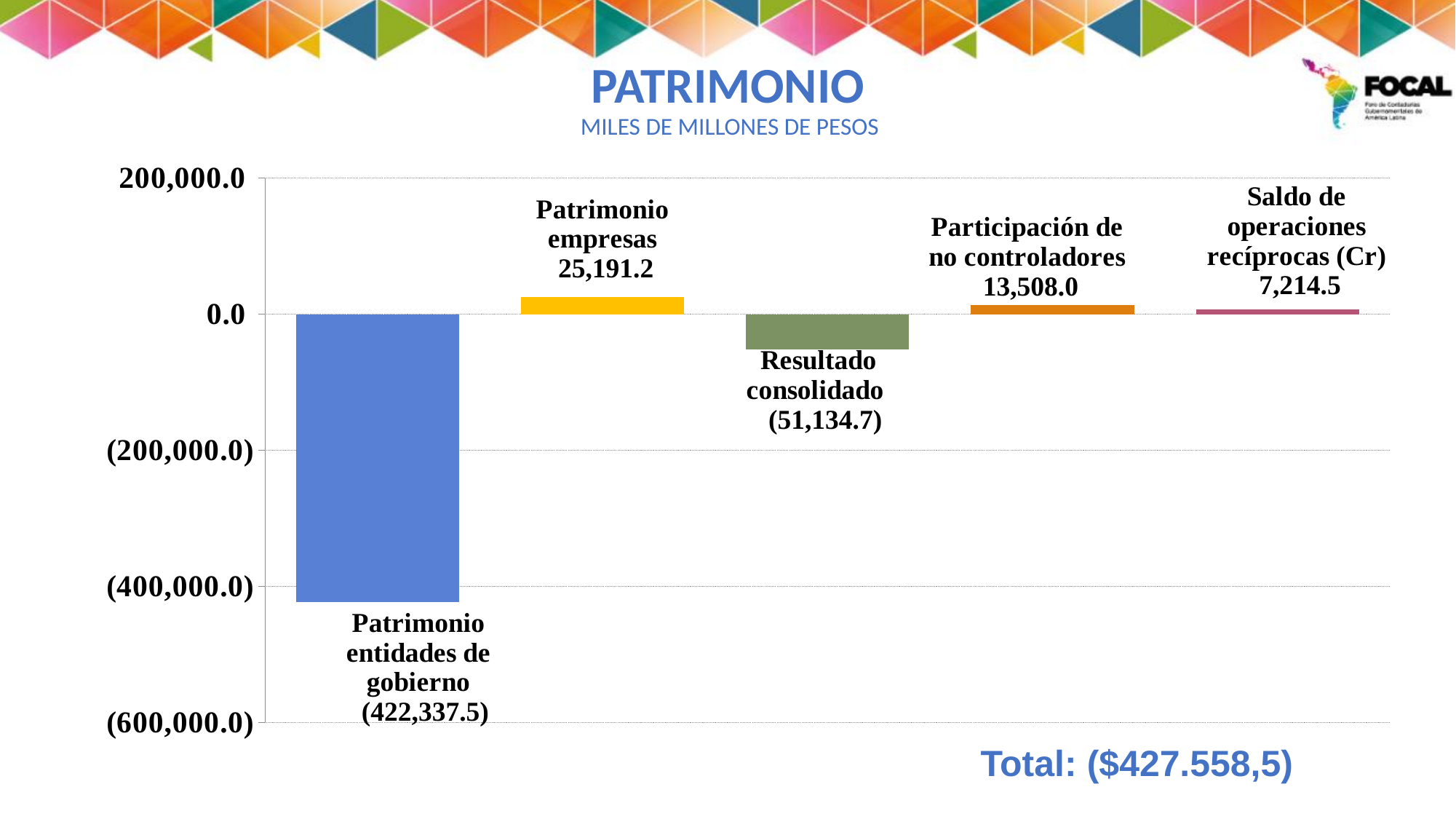
What total is printed below the chart? ($427.558,5) Which category has the lowest value? Patrimonio entidades de gobierno Which is larger, the value for Participación de no controladores or the value for Saldo de operaciones recíprocas (Cr)? Participación de no controladores What is the value for Saldo de operaciones recíprocas (Cr)? 7,214.5 What is the value for Patrimonio entidades de gobierno? (422,337.5) What is the value for Participación de no controladores? 13,508.0 What is the value for Patrimonio empresas? 25,191.2 What kind of chart is shown on the slide? Bar chart What is the difference between the values for Patrimonio empresas and Participación de no controladores? 11,683.2 What is the value for Resultado consolidado? (51,134.7) Which category has the highest value? Patrimonio empresas How many categories are shown in the chart? 5